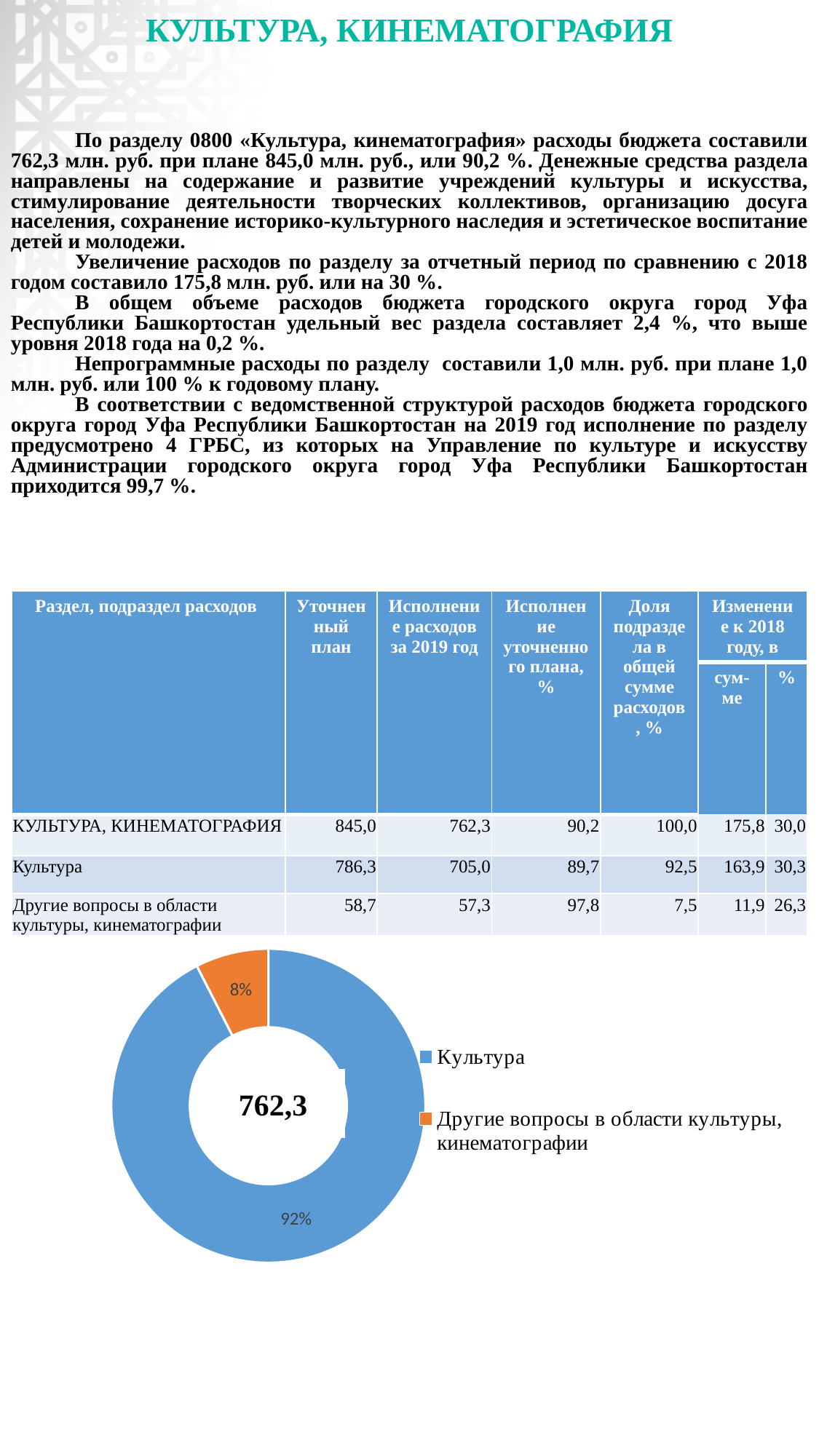
What number is printed in the centre of the doughnut chart? 762,3 What colour is the Культура slice in the doughnut chart? Blue What percentage is shown for the Культура slice in the doughnut chart? 92% Which category has the smallest slice in the doughnut chart? Другие вопросы в области культуры, кинематографии Which category has the largest slice in the doughnut chart? Культура Is the share for Культура greater or less than 50%? greater What kind of chart is shown at the bottom of the slide? Doughnut chart How many entries does the legend of the doughnut chart list? 2 By how many percentage points does the Культура slice exceed the Другие вопросы в области культуры, кинематографии slice? 84 percentage points How many slices does the doughnut chart have? 2 What percentage is shown for the slice labelled Другие вопросы в области культуры, кинематографии? 8% Which slice is larger: Культура or Другие вопросы в области культуры, кинематографии? Культура